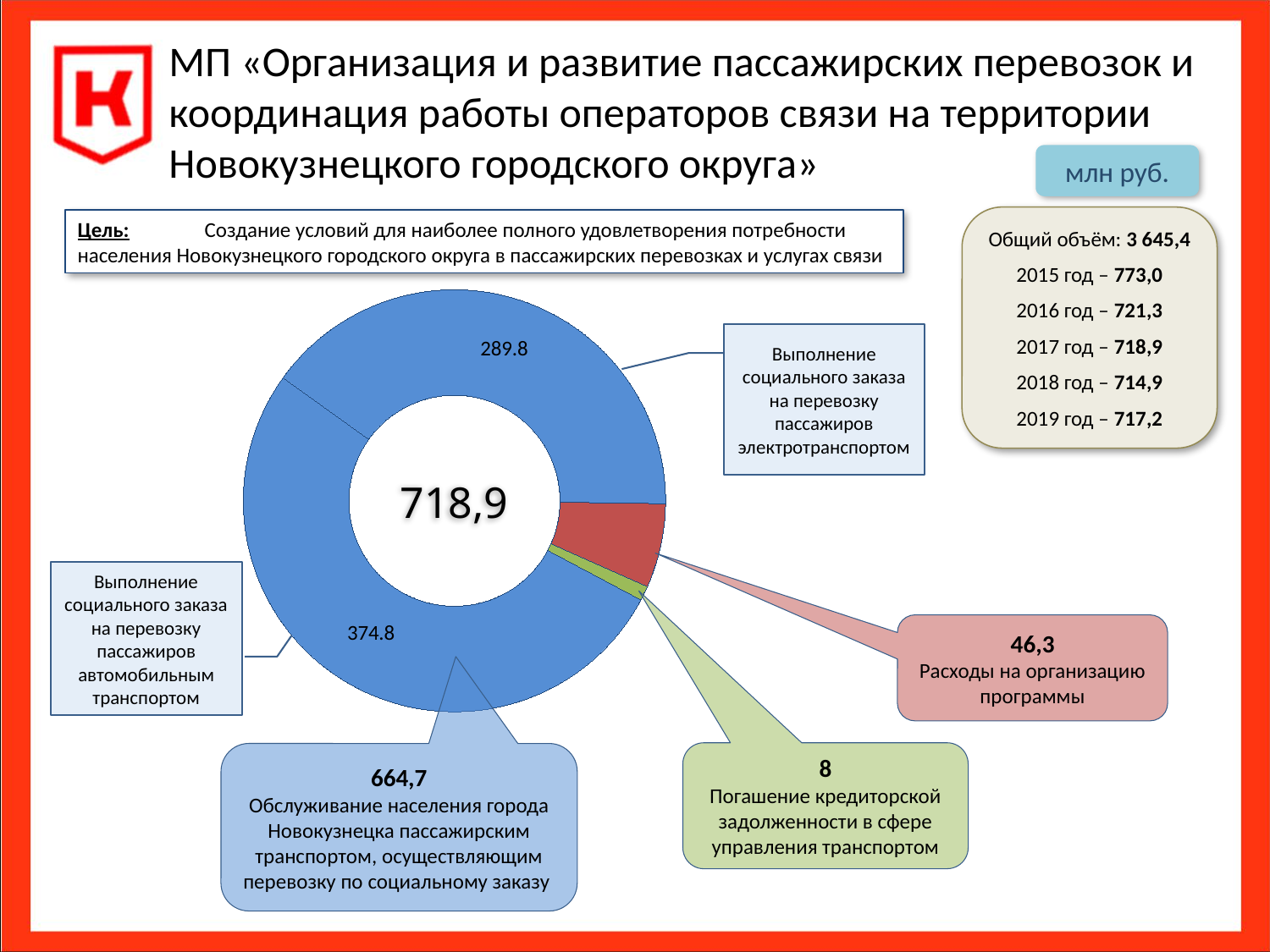
Which segment of the chart has the smallest value? Погашение кредиторской задолженности в сфере управления транспортом What is the difference between 'Расходы на организацию программы' and 'Погашение кредиторской задолженности'? 38,3 What is the difference between the value for automobile transport (374.8) and electrotransport (289.8)? 85 What is the value for 'Расходы на организацию программы'? 46,3 What kind of chart is shown on the slide? doughnut (pie) chart What total value is shown in the centre of the doughnut chart? 718,9 Which is larger: the value for electrotransport or the value for 'Расходы на организацию программы'? electrotransport (289.8) Which segment of the chart has the largest value? Выполнение социального заказа на перевозку пассажиров автомобильным транспортом What is the value for 'Погашение кредиторской задолженности в сфере управления транспортом'? 8 What is the value shown for the segment 'Выполнение социального заказа на перевозку пассажиров автомобильным транспортом'? 374.8 How many segments does the doughnut chart have? 4 What is the value shown for the segment 'Выполнение социального заказа на перевозку пассажиров электротранспортом'? 289.8